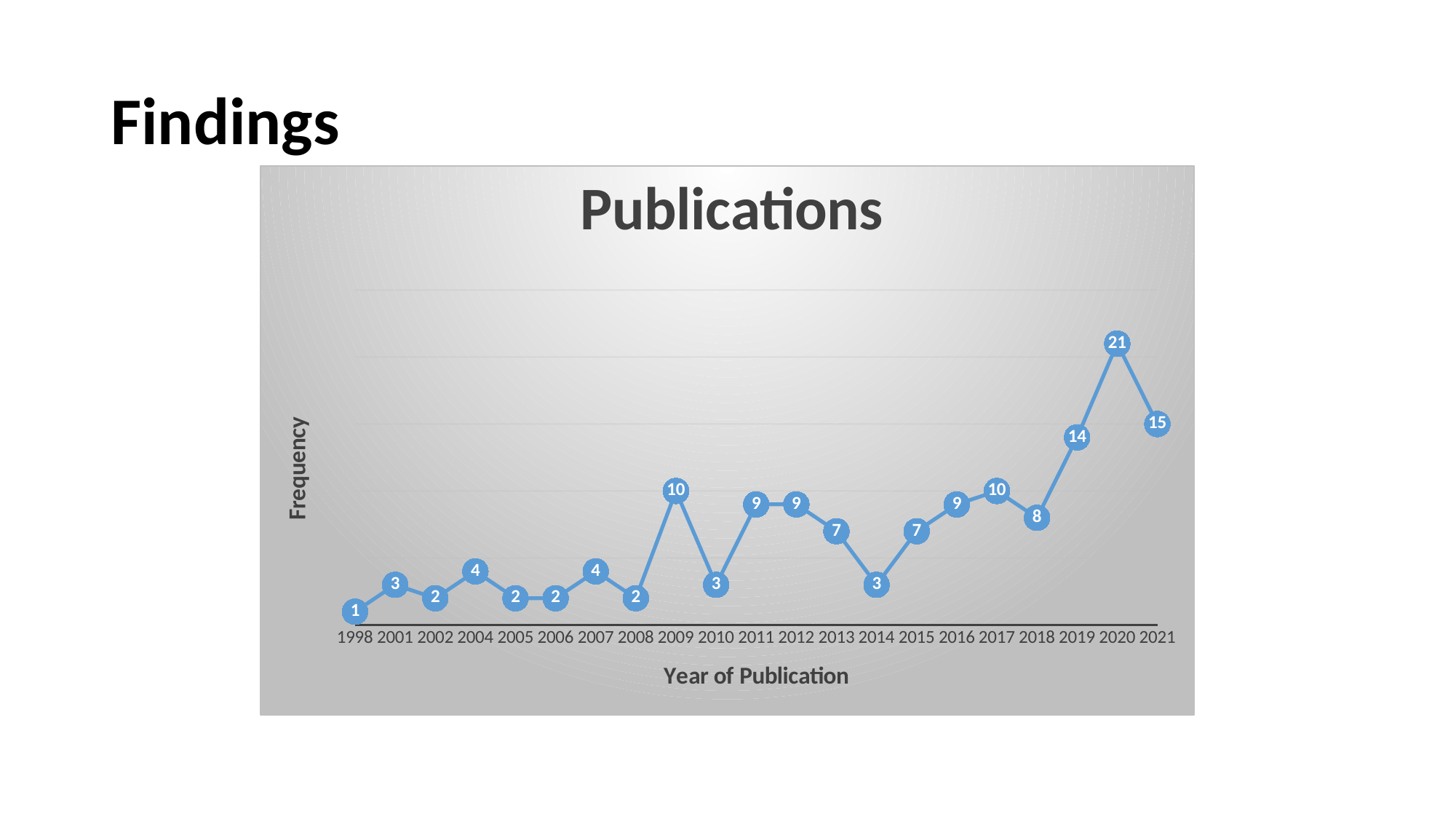
How many years are plotted on the x axis? 21 What is the value for 2009? 10 What is the title of the chart? Publications What is the value for 2020? 21 Do the values generally rise or fall from 2014 to 2020? rise What is the label of the x axis? Year of Publication What is the difference between the values for 2020 and 2021? 6 Which year has the lowest value? 1998 What kind of chart is this? line chart Which year has the highest value? 2020 Which is larger, the value for 2019 or the value for 2017? 2019 What is the value for 1998? 1